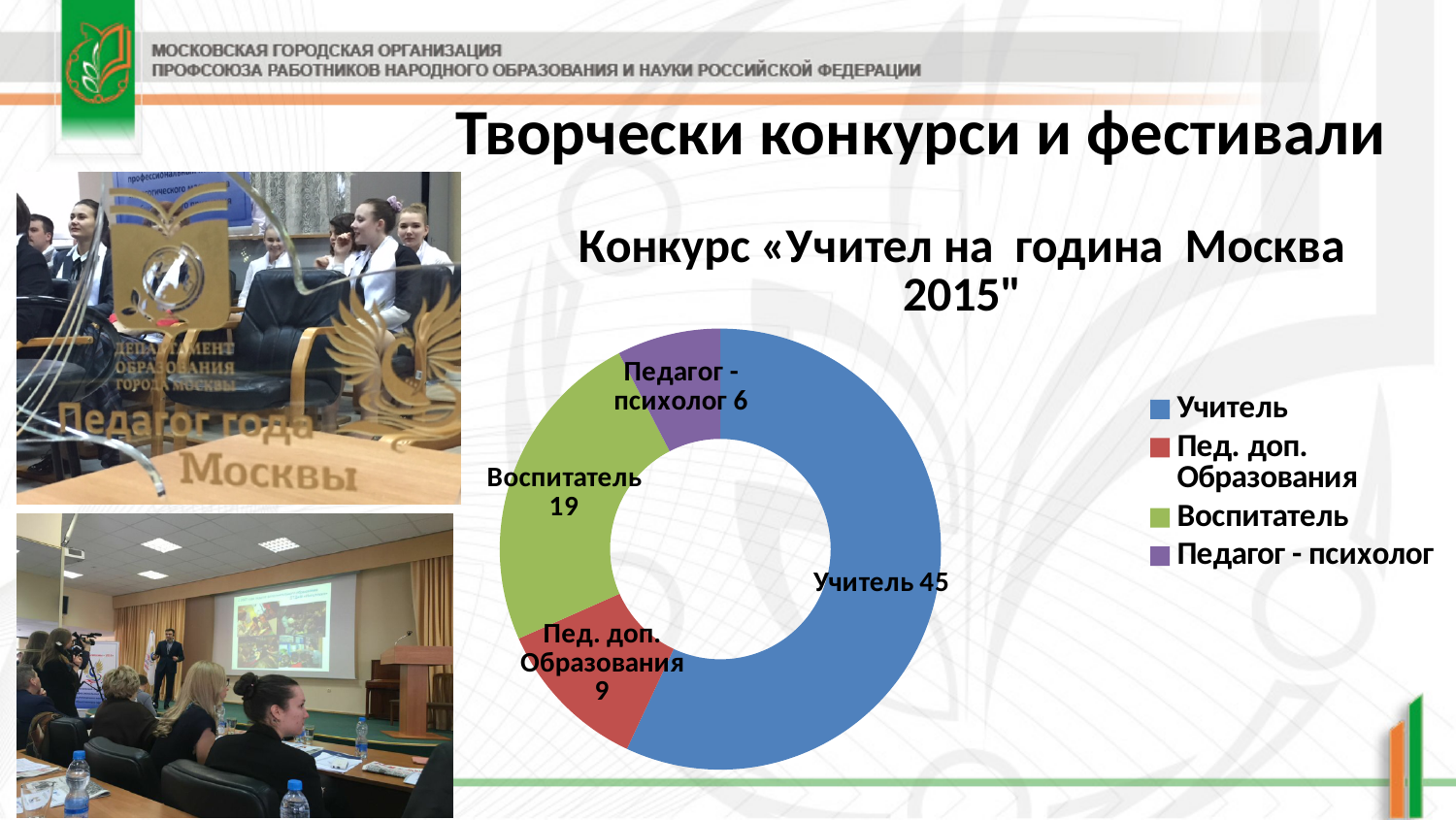
What is the value for Воспитатель in the chart? 19 What is the value for Педагог - психолог in the chart? 6 Which is larger, the value for Воспитатель or the value for Пед. доп. Образования? Воспитатель What is the value for Учитель in the chart «Конкурс «Учител на година Москва 2015»»? 45 What colour represents Воспитатель in the chart? Green Which category has the smallest value in the chart? Педагог - психолог How many categories are shown in the chart? 4 What is the value for Пед. доп. Образования in the chart? 9 What is the total of all values shown in the chart? 79 What is the difference between the values for Учитель and Воспитатель? 26 What type of chart is shown on the slide? Doughnut (ring) chart Which category has the largest value in the chart? Учитель